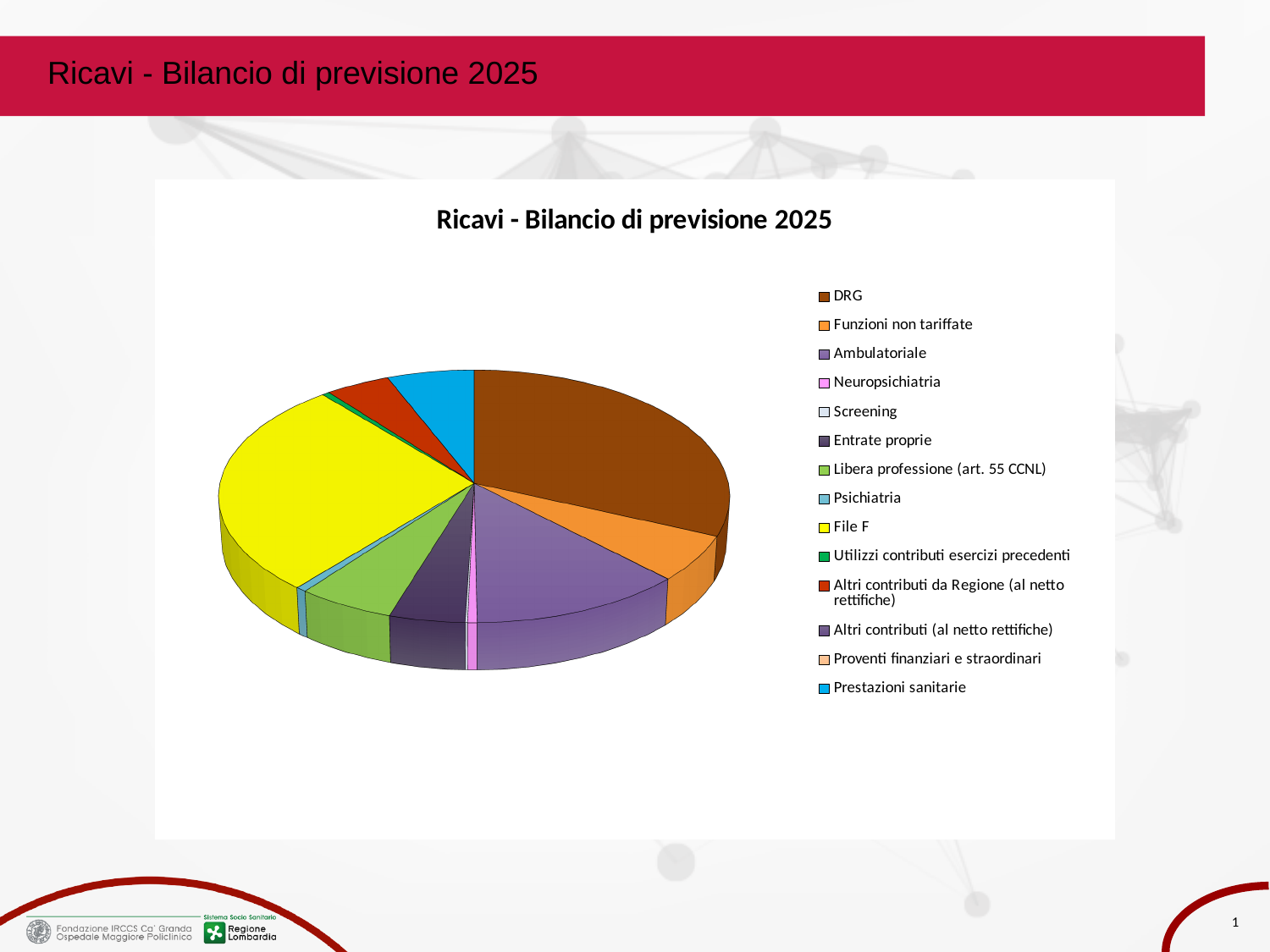
How many categories does the legend of the pie chart list? 14 What kind of chart is shown on the slide? Pie chart Which slice is larger, DRG or Ambulatoriale? DRG Which category has the largest slice of the pie? DRG Which slice is larger, File F or Ambulatoriale? File F Which slice is larger, DRG or Funzioni non tariffate? DRG What colour is the File F slice in the pie chart? Yellow What is the title of the chart? Ricavi - Bilancio di previsione 2025